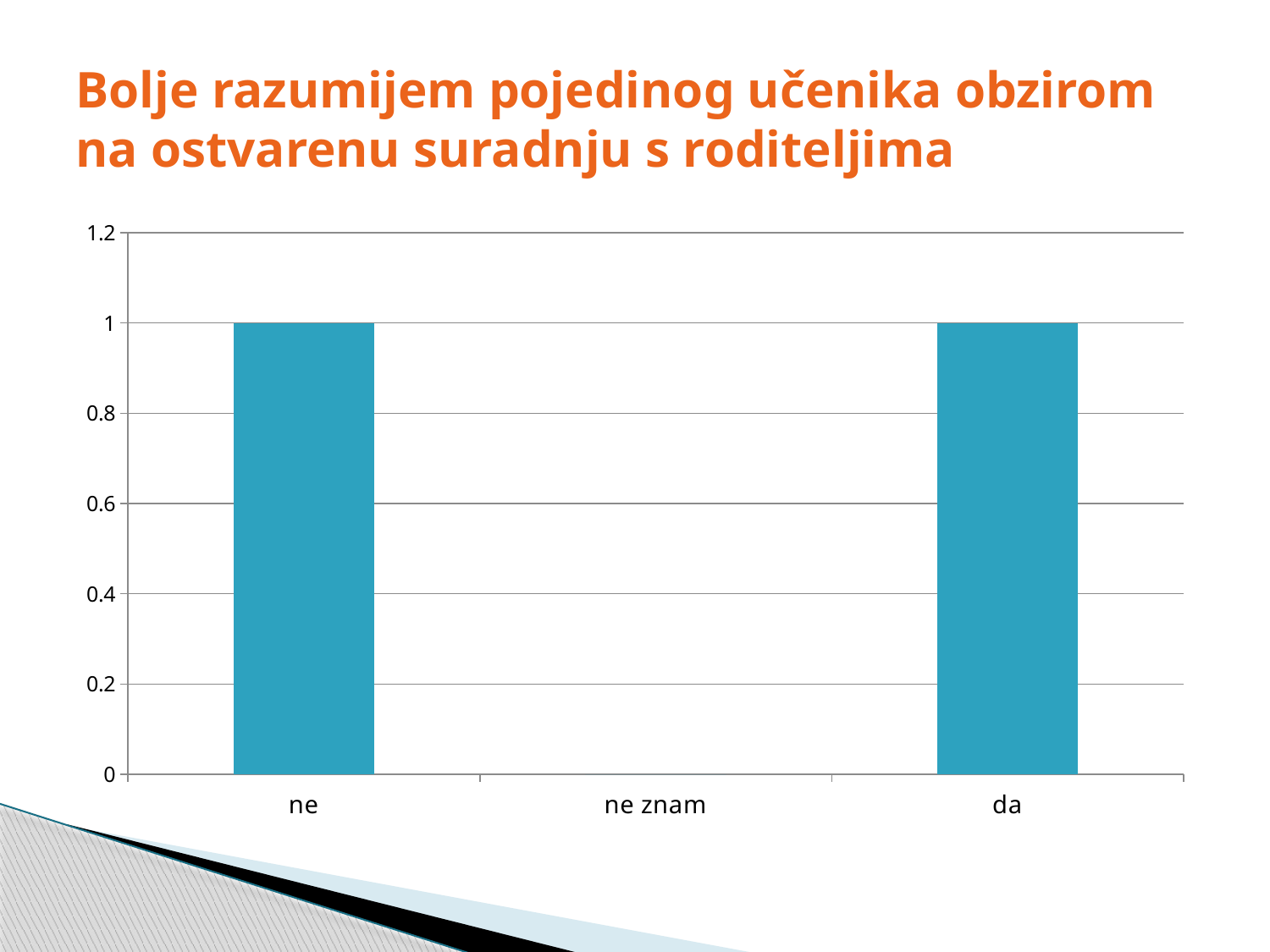
What is the value of the bar for "da"? 1 What kind of chart is shown on the slide? bar chart What is the highest value shown on the vertical axis of the chart? 1.2 Is the value for "ne znam" greater or less than 0.2? less What is the value of the bar for "ne"? 1 Which is larger, the value for "da" or the value for "ne znam"? da Which is larger, the value for "ne" or the value for "ne znam"? ne What is the title of the slide containing the chart? Bolje razumijem pojedinog učenika obzirom na ostvarenu suradnju s roditeljima Which category has the lowest value in the chart? ne znam Is the value for "da" greater or less than 0.8? greater How many categories are shown on the x axis of the chart? 3